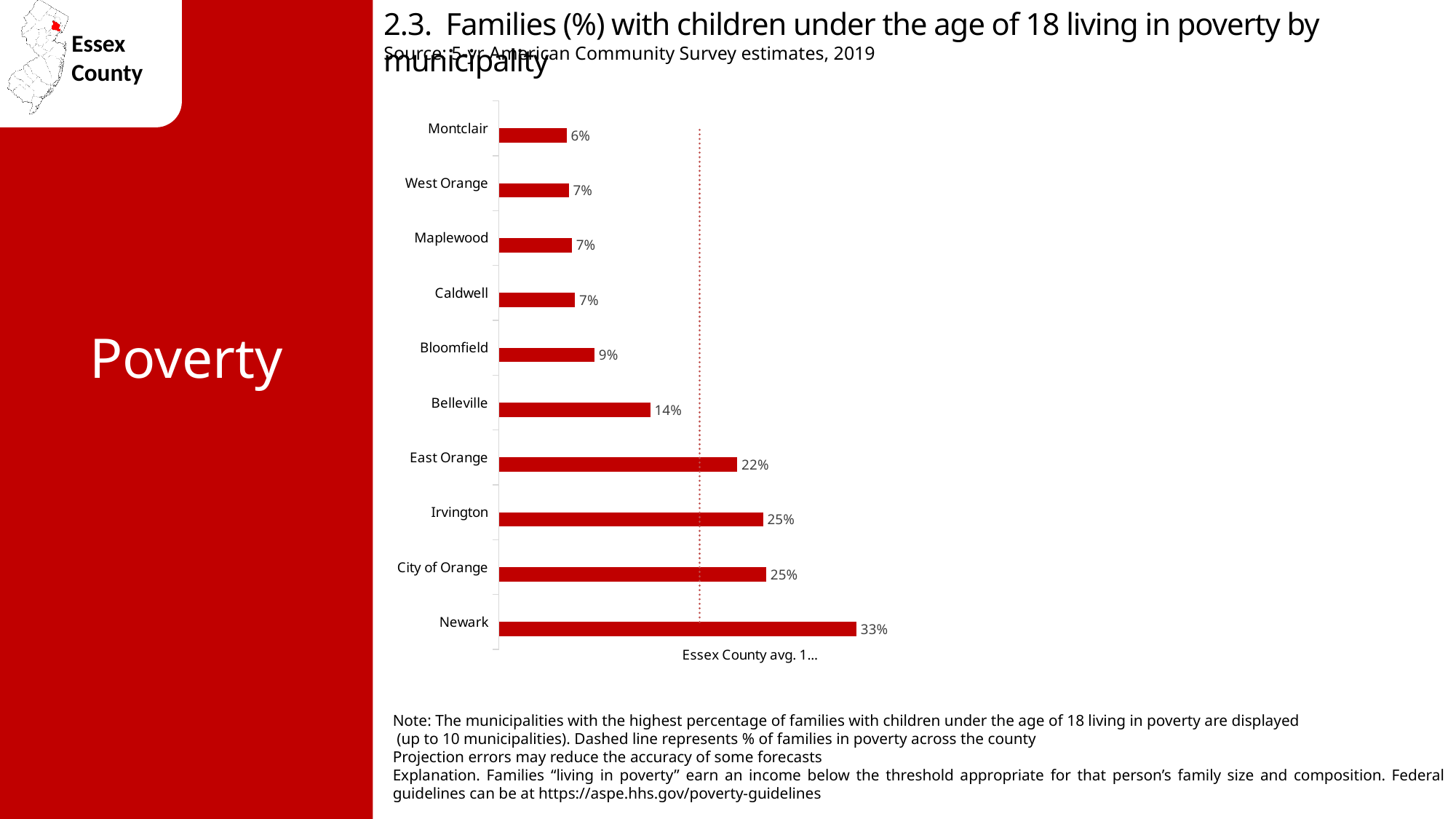
What is the difference between the values for East Orange and Belleville? 8% What is the value shown for Belleville? 14% Which has a higher value, Bloomfield or Belleville? Belleville What is the difference between the values for Newark and Irvington? 8% What type of chart is shown on the slide? Bar chart What does the dashed vertical line on the chart represent? Essex County average Which municipality has the highest percentage of families with children under 18 living in poverty? Newark Which municipality has the lowest percentage shown on the chart? Montclair What percentage of families with children under 18 are living in poverty in Newark? 33% What is the value shown for East Orange? 22% What is the value shown for Bloomfield? 9% How many municipalities are shown on the chart? 10